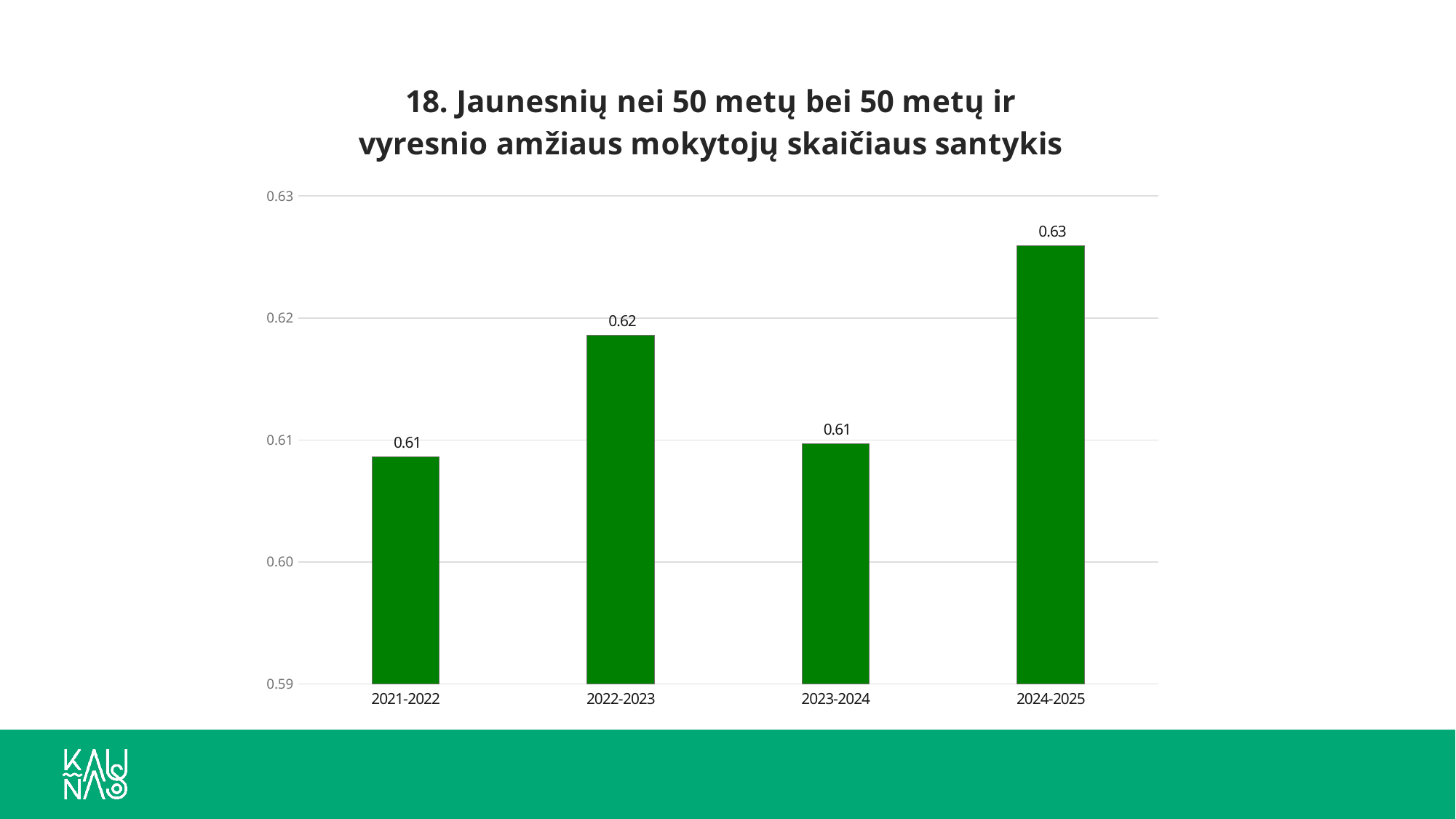
What is the difference between the values for 2024-2025 and 2021-2022? 0.02 What is the difference between the values for 2024-2025 and 2022-2023? 0.01 How many school years are shown on the x axis? 4 What type of chart is shown on the slide? bar chart What is the value for 2022-2023? 0.62 What is the value for 2021-2022? 0.61 Is the value for 2023-2024 greater or less than 0.62? less Is the value for 2024-2025 greater or less than 0.62? greater Which is larger, the value for 2022-2023 or the value for 2023-2024? 2022-2023 Which school year has the highest value? 2024-2025 What is the value for 2023-2024? 0.61 What is the value for 2024-2025? 0.63